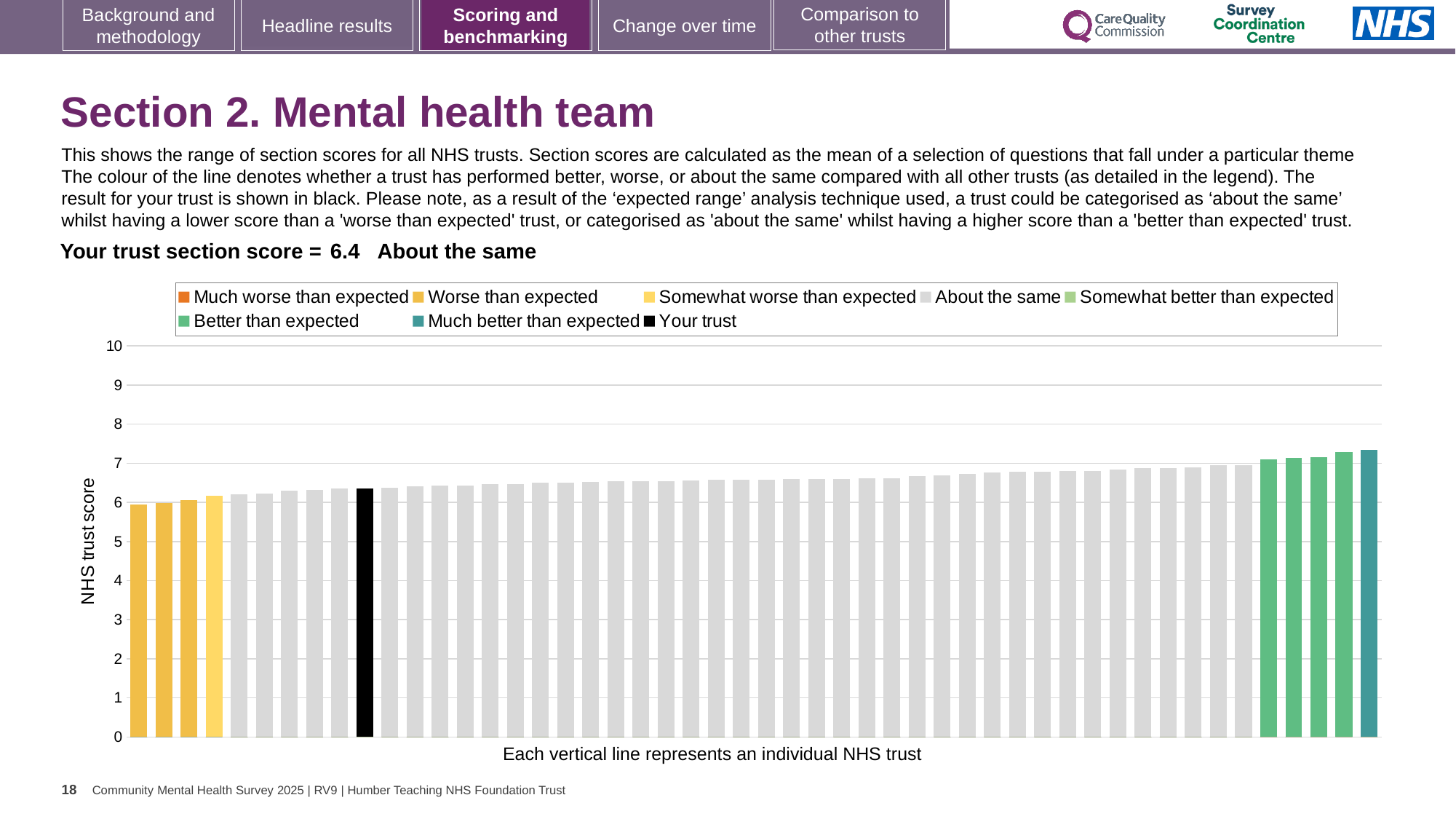
Is the value for the tallest bar greater or less than 8? less Is the bar for your trust higher or lower than the tallest bar in the chart? lower What kind of chart is shown on the slide? bar chart How many bars are coloured as 'Much better than expected'? 1 Do the bar values rise or fall from left to right across the chart? rise How many entries does the chart legend list? 8 What is the section score for your trust shown on the slide? 6.4 Which legend category does the tallest bar in the chart belong to? Much better than expected Is the value for the tallest bar greater or less than 7? greater Which legend category does the shortest bar in the chart belong to? Worse than expected Is the value for the shortest bar greater or less than 5? greater What is the label on the vertical axis of the chart? NHS trust score